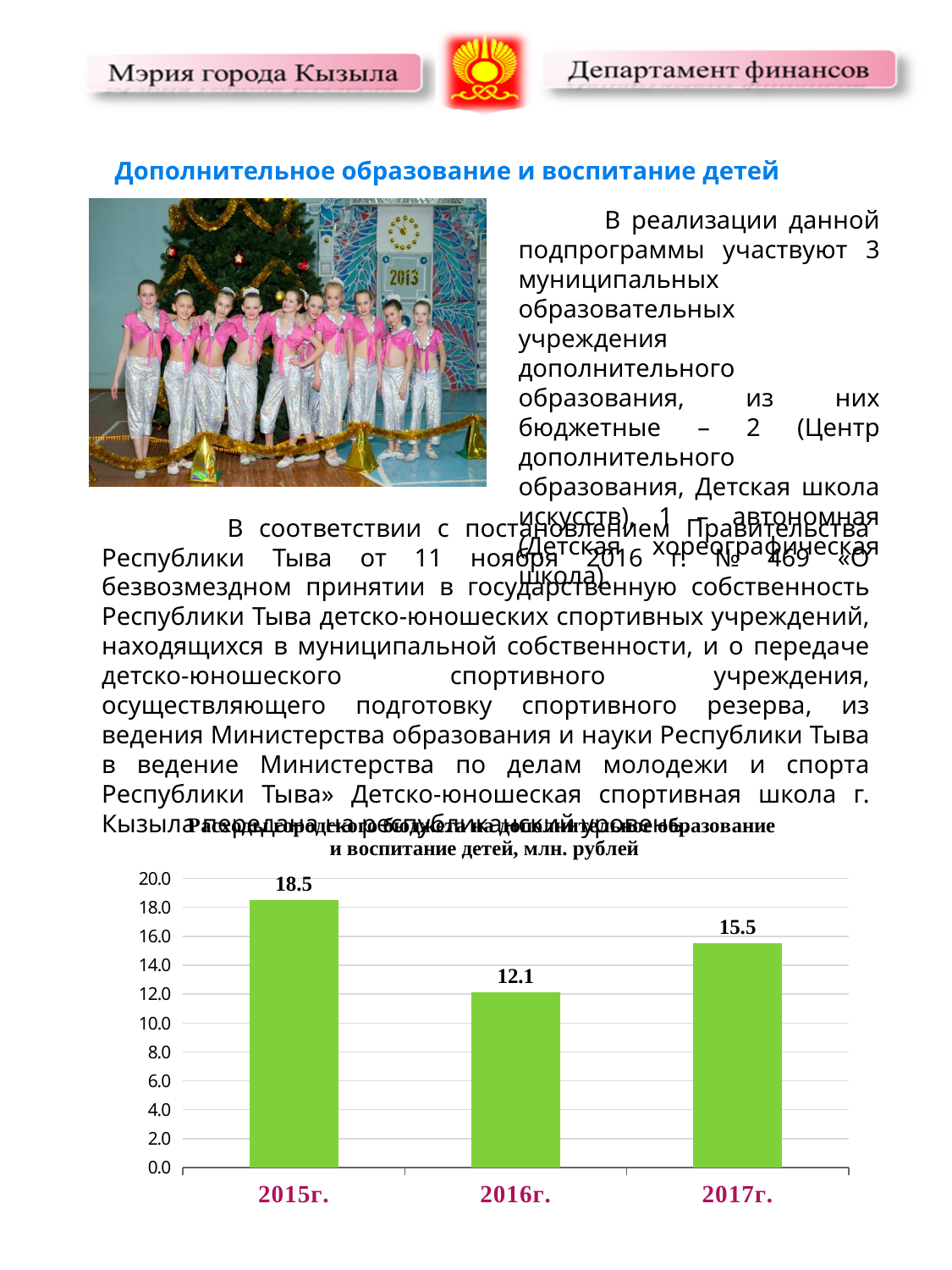
Which year has the highest value? 2015г. Which year has the lowest value? 2016г. Which is larger, the value for 2017г. or the value for 2016г.? 2017г. What is the difference between the values for 2017г. and 2016г.? 3.4 What is the value for 2016г.? 12.1 What is the value for 2017г.? 15.5 What is the value for 2015г.? 18.5 What is the difference between the values for 2015г. and 2016г.? 6.4 How many years are shown on the chart? 3 Does the value rise or fall from 2015г. to 2016г.? fall Is the value for 2016г. greater or less than 14.0? less What kind of chart is shown on the slide? bar chart